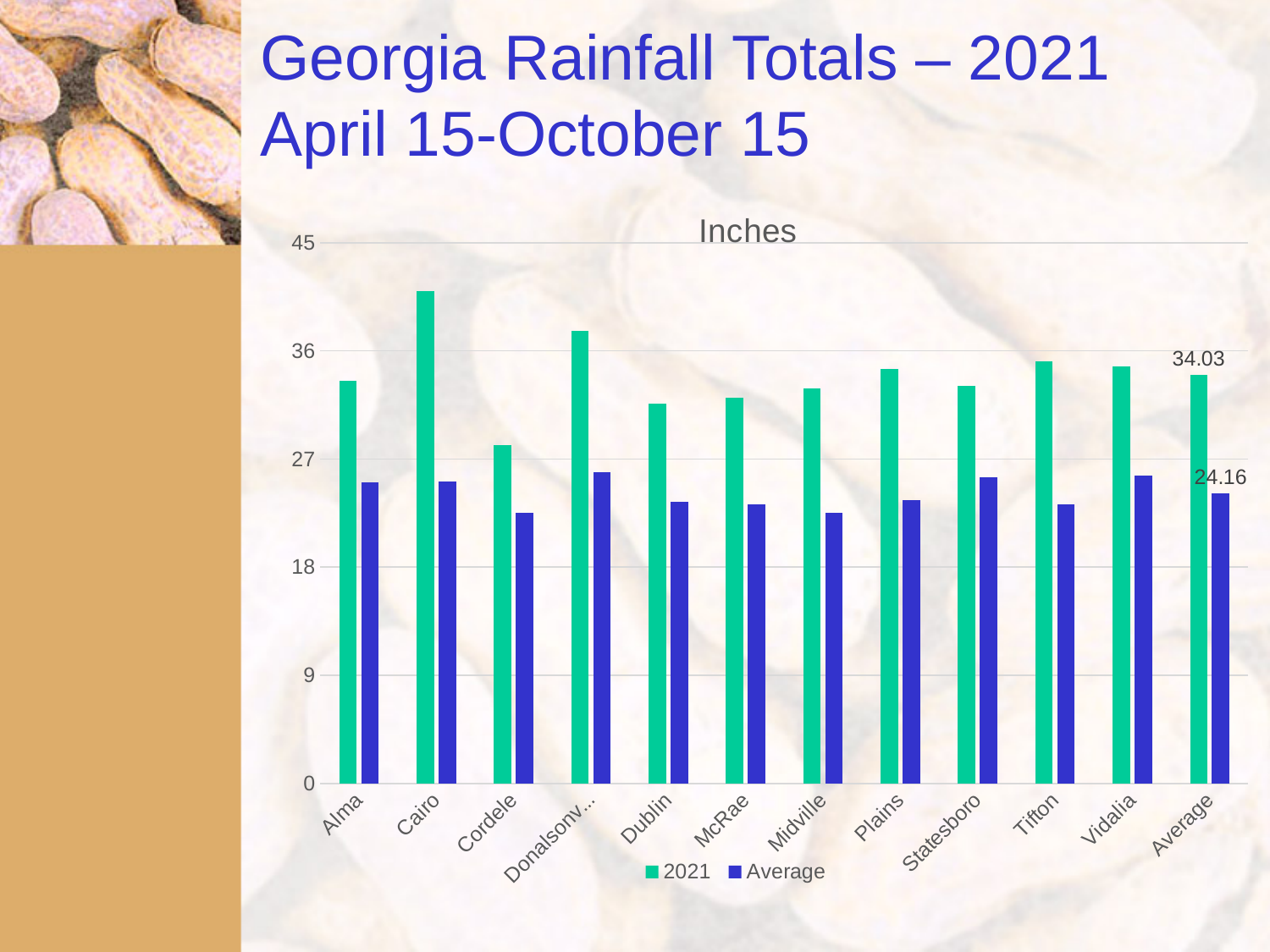
Which location has the lowest 2021 rainfall? Cordele What is the 2021 value for the Average category? 34.03 What type of chart is shown on the slide? bar chart Is the 2021 value for Cairo greater or less than 36? greater Is the 2021 value for Alma greater or less than 36? less Which is larger for Dublin, the 2021 value or the Average value? 2021 Is the Average value for Alma greater or less than 27? less What is the title of the chart? Inches Which location has the highest 2021 rainfall? Cairo How many series does the legend list? 2 What is the Average series value for the Average category? 24.16 What is the difference between the 2021 value and the Average value for the Average category? 9.87